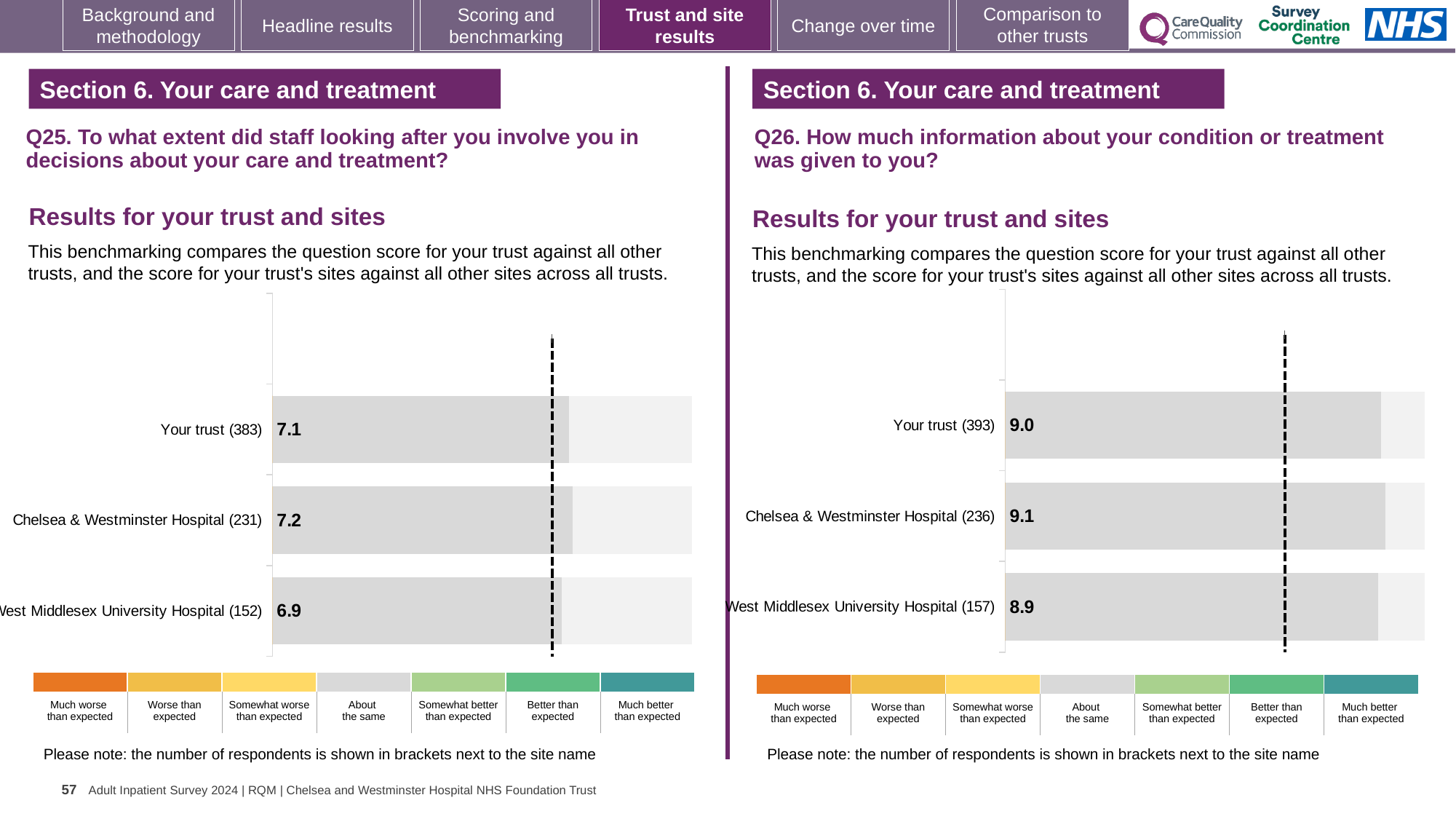
In the Q26 chart on the right, what is the difference between the scores for Chelsea & Westminster Hospital (236) and Your trust (393)? 0.1 In the Q25 chart on the left, what is the score for Your trust (383)? 7.1 How many bars are plotted in the Q25 chart on the left? 3 In the Q26 chart on the right, which has the higher score: Your trust (393) or West Middlesex University Hospital (157)? Your trust (393) In the Q25 chart on the left, which site or trust has the highest score? Chelsea & Westminster Hospital (231) In the Q26 chart on the right, what is the score for Your trust (393)? 9.0 In the Q25 chart on the left, what is the score for Chelsea & Westminster Hospital (231)? 7.2 In the Q26 chart on the right, which site or trust has the lowest score? West Middlesex University Hospital (157) What type of chart is used for the Q26 results on the right? Bar chart In the Q25 chart on the left, what is the score for West Middlesex University Hospital (152)? 6.9 In the Q26 chart on the right, what is the score for West Middlesex University Hospital (157)? 8.9 In the Q25 chart on the left, what is the difference between the scores for Chelsea & Westminster Hospital (231) and West Middlesex University Hospital (152)? 0.3